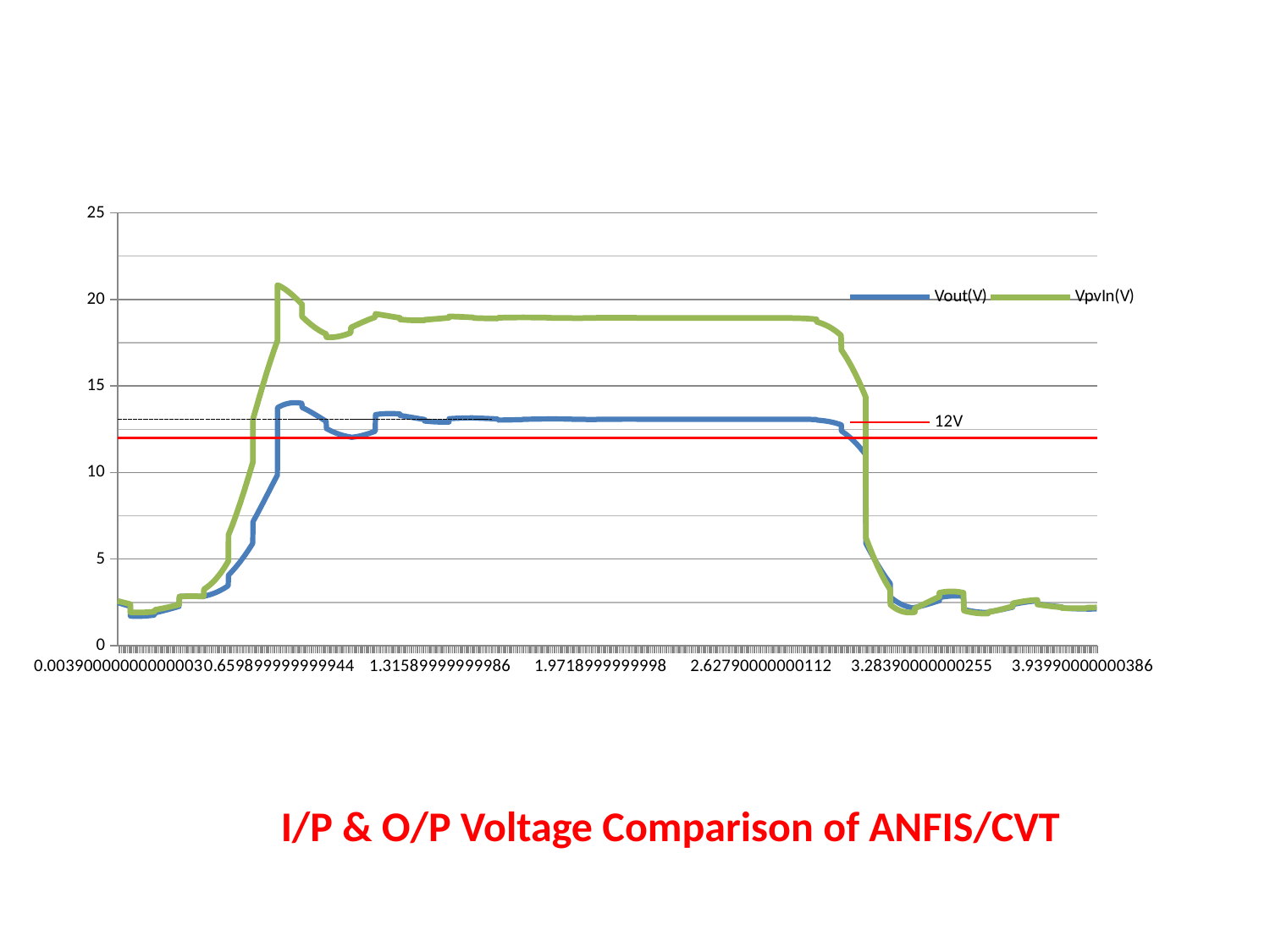
Is the peak value of VpvIn(V) greater or less than 20? greater Which series reaches the higher peak value, Vout(V) or VpvIn(V)? VpvIn(V) During the middle plateau of the chart, is the Vout(V) value greater or less than 10? greater During the middle plateau of the chart, is the VpvIn(V) value greater or less than 15? greater How many series does the legend list? 2 What is the maximum value shown on the vertical axis? 25 What kind of chart is shown on the slide? line chart What are the two series named in the legend? Vout(V) and VpvIn(V) What value is the red horizontal reference line labelled with? 12V What colour is the Vout(V) line? blue Does the Vout(V) line rise or fall between the x-axis ticks 2.62790000000112 and 3.28390000000255? fall